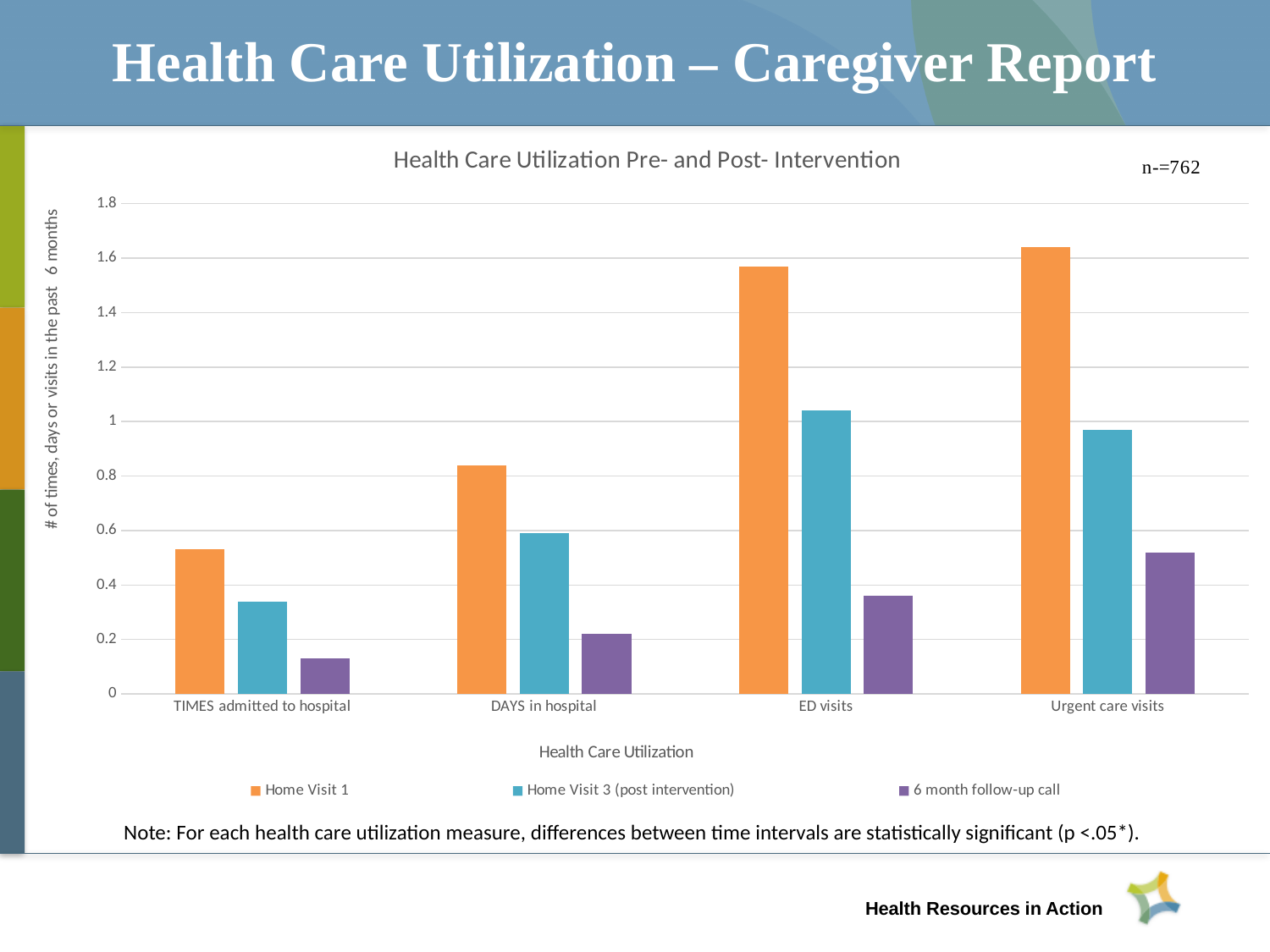
Which category has the highest 6 month follow-up call value? Urgent care visits What is the title of the chart? Health Care Utilization Pre- and Post- Intervention Is the 6 month follow-up call value for TIMES admitted to hospital greater or less than 0.2? less What type of chart is shown on the slide? Bar chart Is the Home Visit 1 value for ED visits greater or less than 1.4? greater Is the 6 month follow-up call value for Urgent care visits greater or less than 0.4? greater Which category has the lowest Home Visit 1 value? TIMES admitted to hospital Which is larger: the Home Visit 3 (post intervention) value for DAYS in hospital or for TIMES admitted to hospital? DAYS in hospital How many series does the legend list? 3 Within each category, do the values rise or fall from Home Visit 1 to the 6 month follow-up call? fall How many health care utilization categories are shown on the x axis? 4